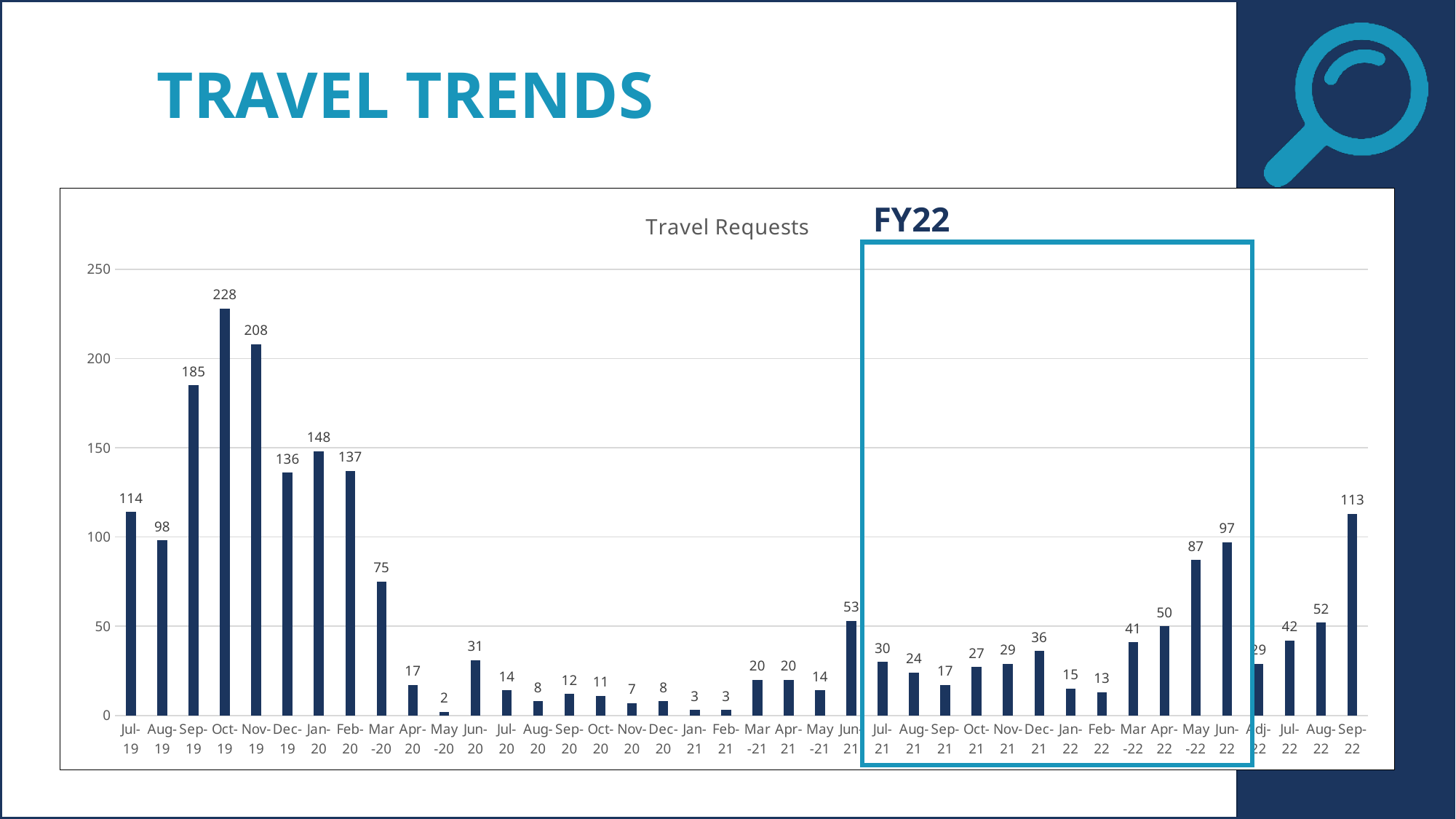
Which month has the highest number of travel requests? Oct-19 Which is larger, the value for Jun-21 or the value for Apr-22? Jun-21 What is the difference between the travel requests for Jun-22 and May-22? 10 What is the value for Oct-19 in the Travel Requests chart? 228 What is the difference between the travel requests for Oct-19 and Nov-19? 20 Which month has the lowest number of travel requests? May-20 What is the value for Sep-22 in the Travel Requests chart? 113 How many bars are plotted in the Travel Requests chart? 40 What label is shown above the highlighted box on the chart? FY22 What is the value for Jun-22 in the Travel Requests chart? 97 What type of chart is shown on the slide? Bar chart Which is larger, the value for Jul-19 or the value for Sep-22? Jul-19